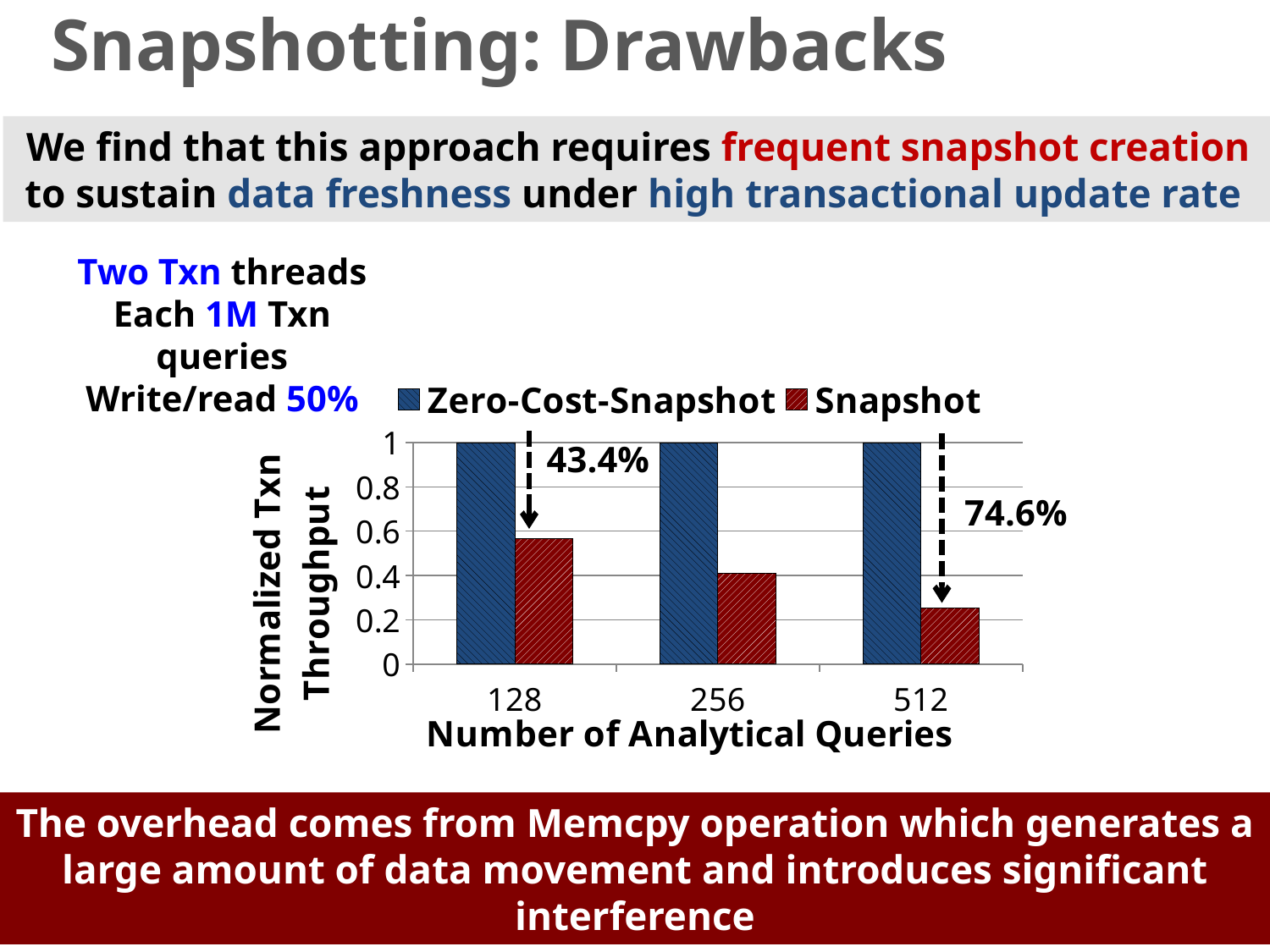
What is the Normalized Txn Throughput for Zero-Cost-Snapshot at 512 analytical queries? 1 What is the Normalized Txn Throughput for Zero-Cost-Snapshot at 128 analytical queries? 1 How many series does the chart legend list? 2 For the Snapshot series, at which number of analytical queries is the throughput lowest? 512 What percentage drop is annotated above the Snapshot bar at 512 analytical queries? 74.6% Is the Snapshot value at 512 analytical queries greater or less than 0.4? less At 256 analytical queries, which series has the larger value, Zero-Cost-Snapshot or Snapshot? Zero-Cost-Snapshot Does the Snapshot throughput rise or fall as the number of analytical queries increases? fall Is the Snapshot value at 128 analytical queries greater or less than 0.4? greater For the Snapshot series, at which number of analytical queries is the throughput highest? 128 What kind of chart is shown on the slide? bar chart How many categories are shown on the x axis of the chart? 3